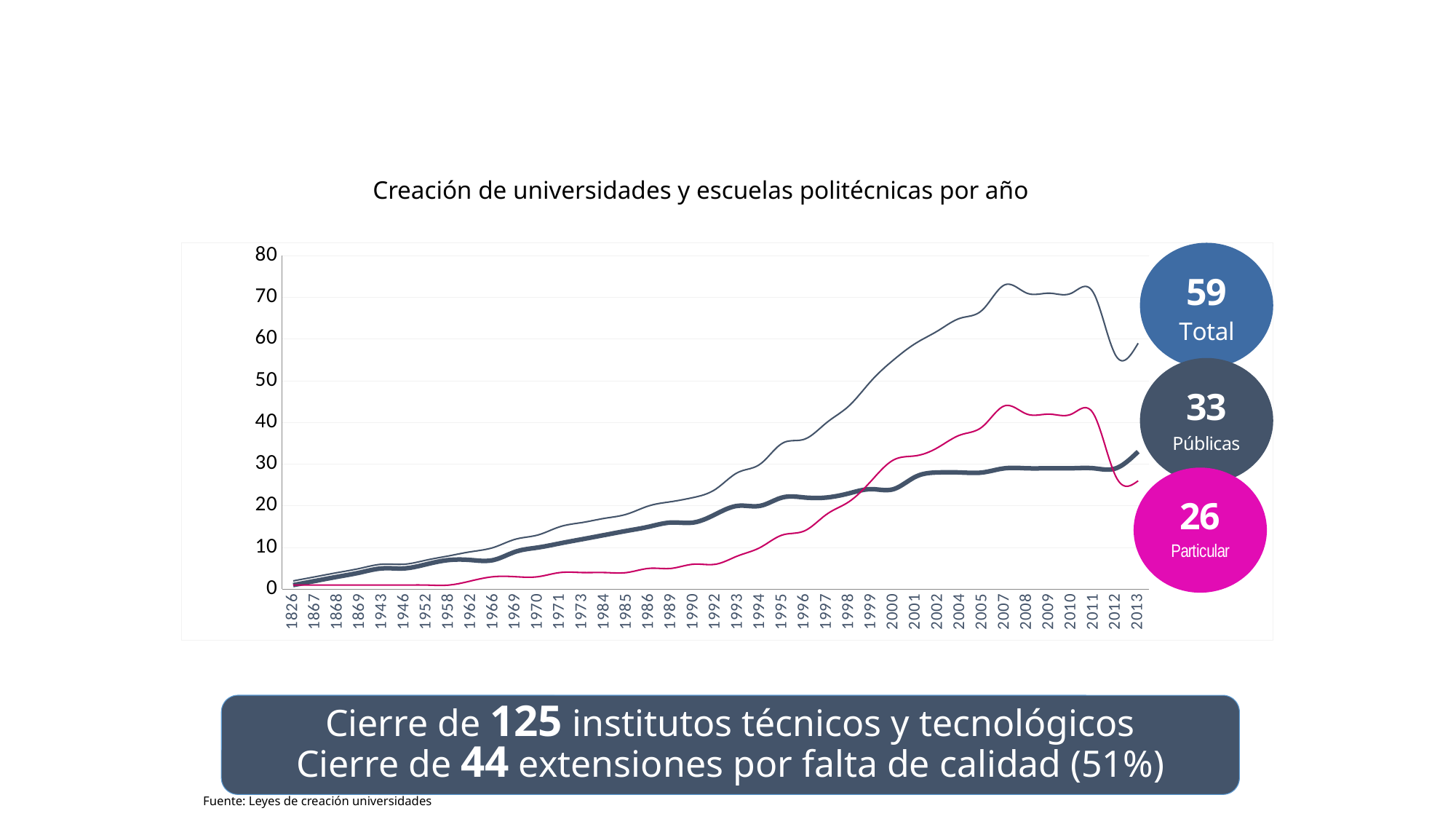
What is the Total value shown for 2013? 59 What is the value for Públicas shown for 2013? 33 In 2013, which is larger, Públicas or Particular? Públicas What is the difference between the Públicas and Particular values in 2013? 7 What is the difference between the Total and the Públicas values in 2013? 26 Is the Públicas value for 2000 greater or less than 30? less What is the title of the chart? Creación de universidades y escuelas politécnicas por año What is the value for Particular shown for 2013? 26 What kind of chart is shown on the slide? line chart Does the Total line generally rise or fall from 1826 to 2007? rise Is the Total value for 2007 greater or less than 70? greater Is the Particular value for 1990 greater or less than 10? less